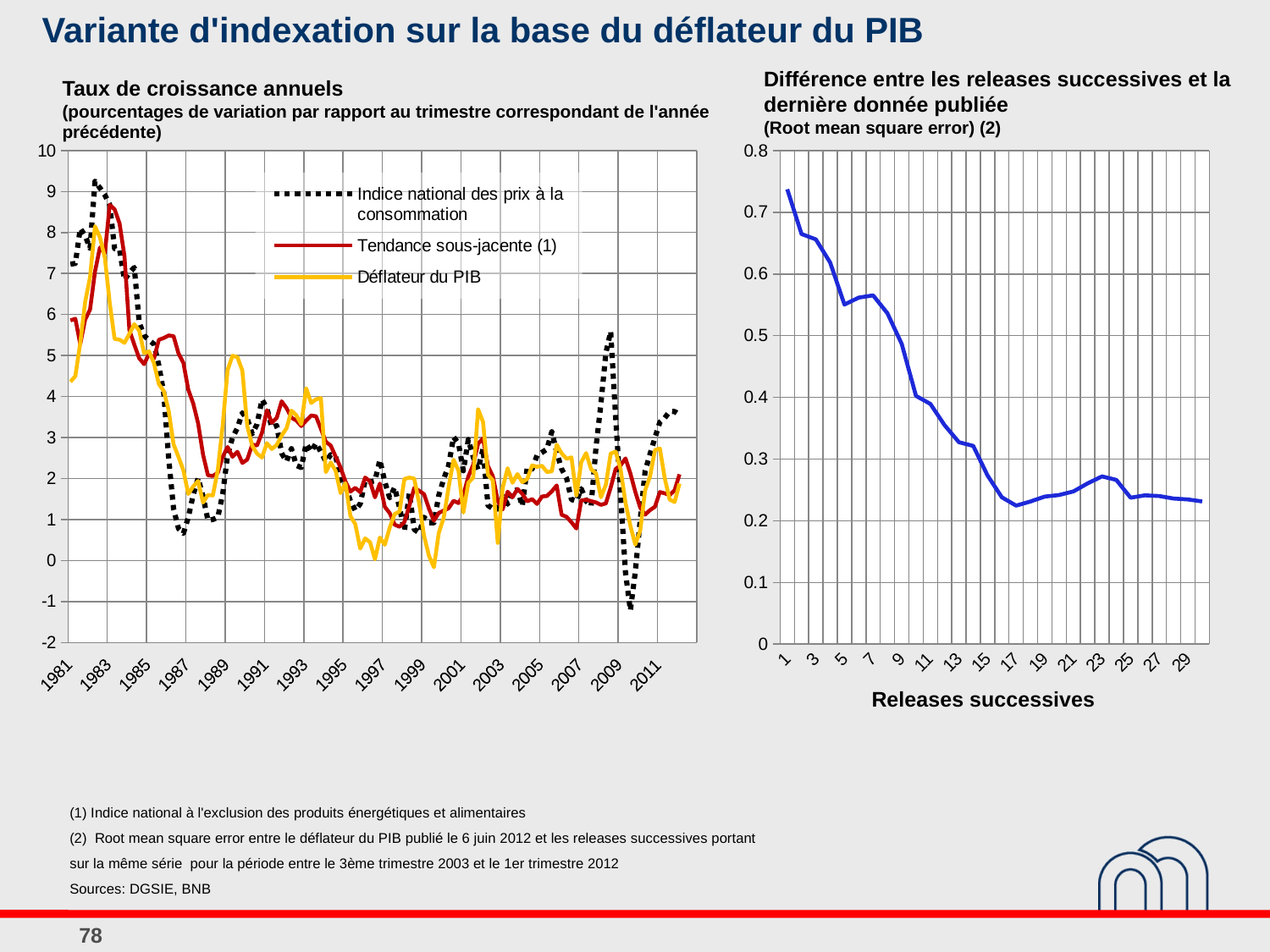
In the left chart "Taux de croissance annuels", is the lowest value of the Indice national des prix à la consommation series around 2009 greater or less than 0? less In the right chart "Différence entre les releases successives et la dernière donnée publiée", is the value at release 1 greater or less than 0.7? greater In the right chart "Différence entre les releases successives et la dernière donnée publiée", do the values rise or fall as the release number increases? fall In the left chart "Taux de croissance annuels", do the values of the Tendance sous-jacente (1) series overall rise or fall between 1983 and 2011? fall In the left chart "Taux de croissance annuels", is the peak value of the Déflateur du PIB series around 1982 greater or less than 7? greater What is the x-axis title of the right chart "Différence entre les releases successives et la dernière donnée publiée"? Releases successives In the left chart "Taux de croissance annuels", which series is drawn as a dotted black line? Indice national des prix à la consommation What kind of chart is the left chart titled "Taux de croissance annuels"? line chart How many series does the legend of the left chart "Taux de croissance annuels" list? 3 What kind of chart is the right chart titled "Différence entre les releases successives et la dernière donnée publiée"? line chart